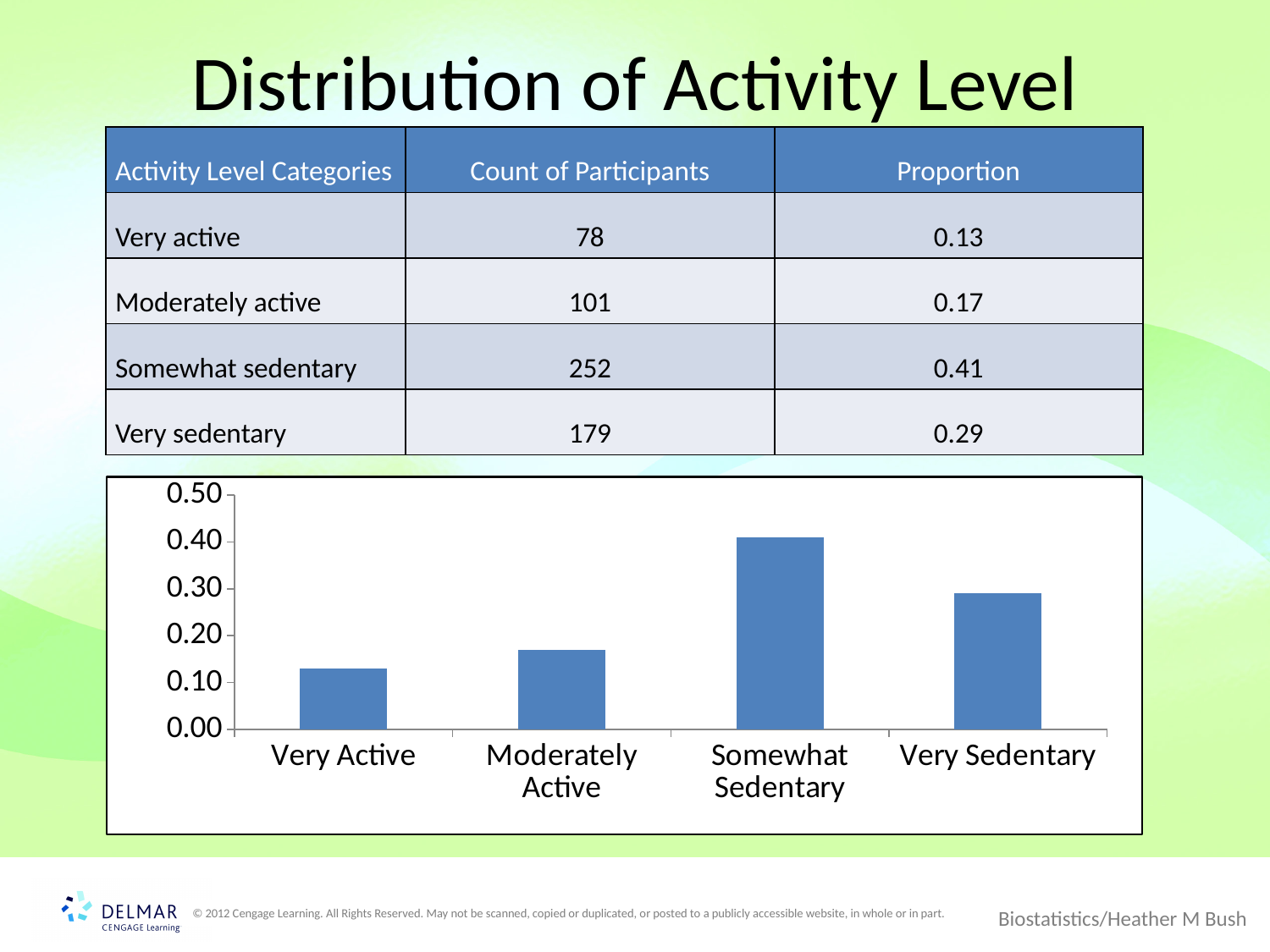
Which bar is taller, Very Sedentary or Moderately Active? Very Sedentary What is the highest value shown on the chart's y axis? 0.50 How many categories are plotted on the x axis of the chart? 4 Is the value for Moderately Active greater or less than 0.20? less Is the value for Somewhat Sedentary greater or less than 0.40? greater Is the value for Very Active greater or less than 0.20? less What proportion is plotted for Somewhat Sedentary, as given in the table on the slide? 0.41 Which category has the lowest bar in the chart? Very Active What kind of chart is shown on the slide? bar chart Which category has the highest bar in the chart? Somewhat Sedentary What is the difference between the proportions for Somewhat sedentary and Very active, using the values in the table? 0.28